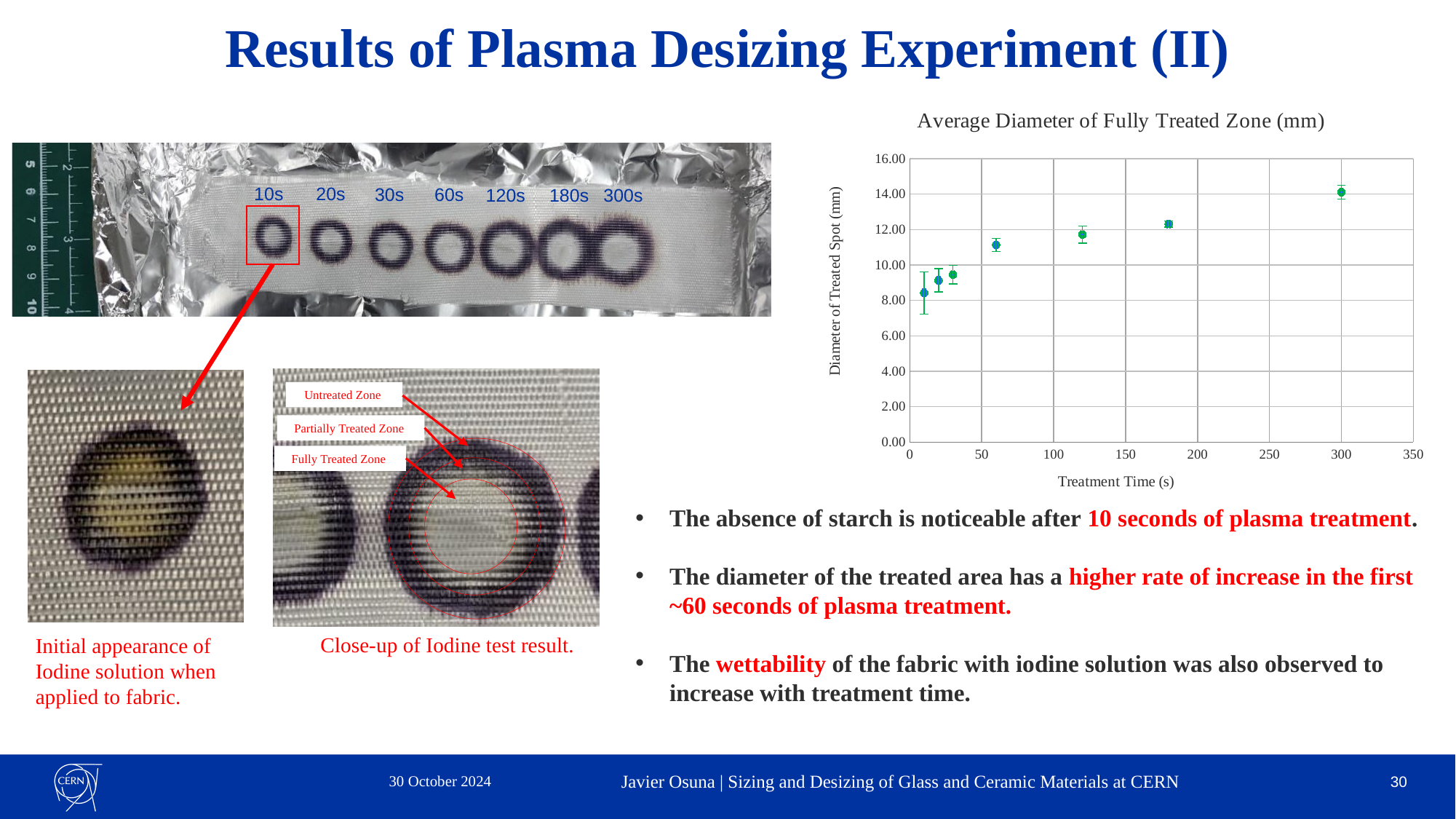
What is the title of the chart? Average Diameter of Fully Treated Zone (mm) At which treatment time is the diameter of the treated spot highest? 300 s What kind of chart is shown on the slide? scatter chart Which has the larger diameter value, the point at 60 s or the point at 20 s? 60 s How many data points are plotted in the chart? 7 Is the diameter value at 60 s treatment time greater or less than 10.00? greater Is the diameter value at 10 s treatment time greater or less than 10.00? less Is the diameter value at 180 s treatment time greater or less than 10.00? greater Do the diameter values rise or fall as treatment time increases? rise Which has the larger diameter value, the point at 300 s or the point at 10 s? 300 s What is the label of the x axis of the chart? Treatment Time (s)